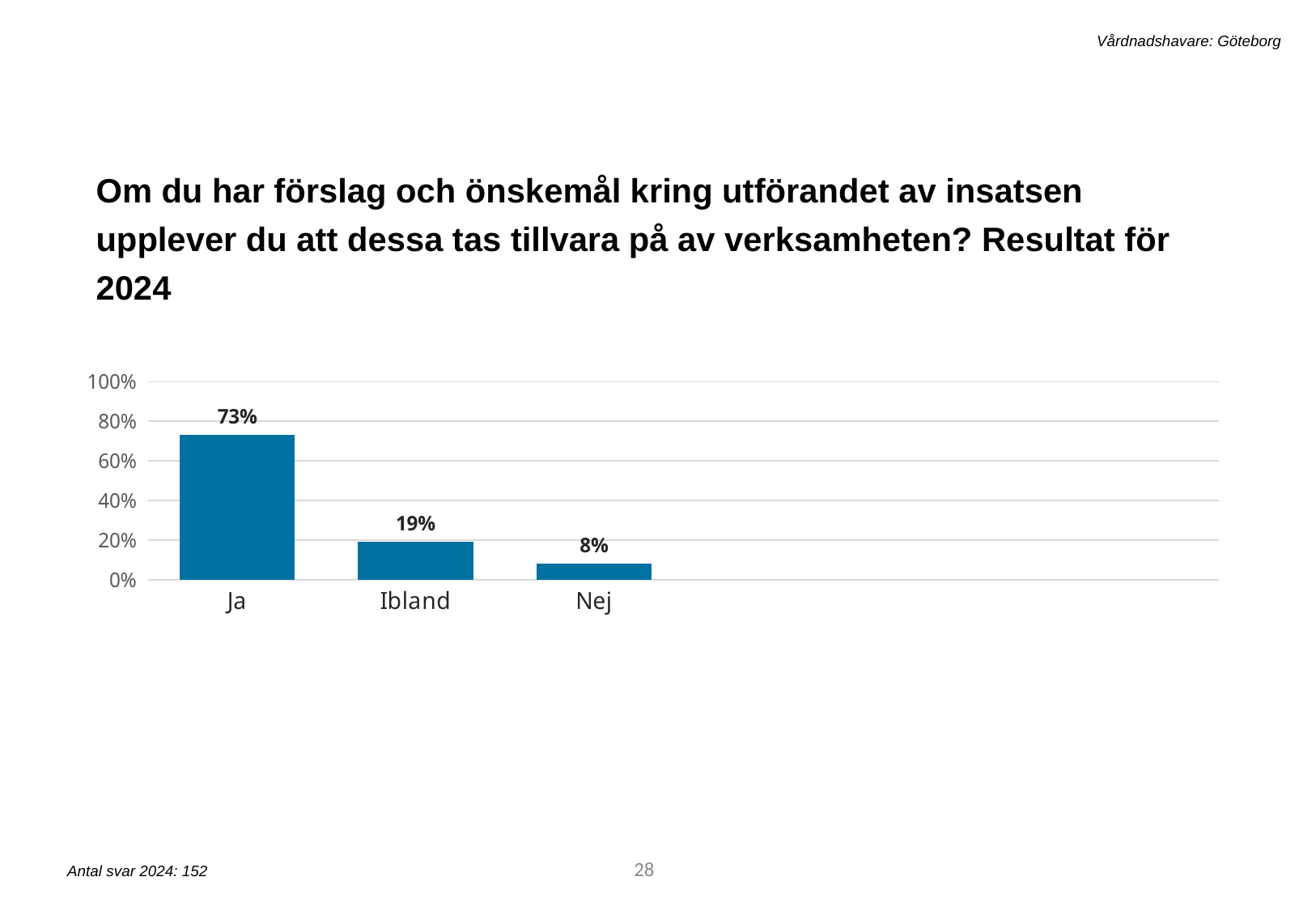
Which category has the highest value? Ja Is the value for Ja greater or less than 60%? greater What kind of chart is shown on the slide? bar chart Which category has the lowest value? Nej What is the value for Ibland? 19% Do the values rise or fall from left to right along the x axis? fall What is the value for Ja? 73% What is the difference between the values for Ja and Ibland? 54% Which is larger, the value for Ibland or the value for Nej? Ibland How many categories are shown on the x axis? 3 What is the value for Nej? 8% What is the difference between the values for Ibland and Nej? 11%